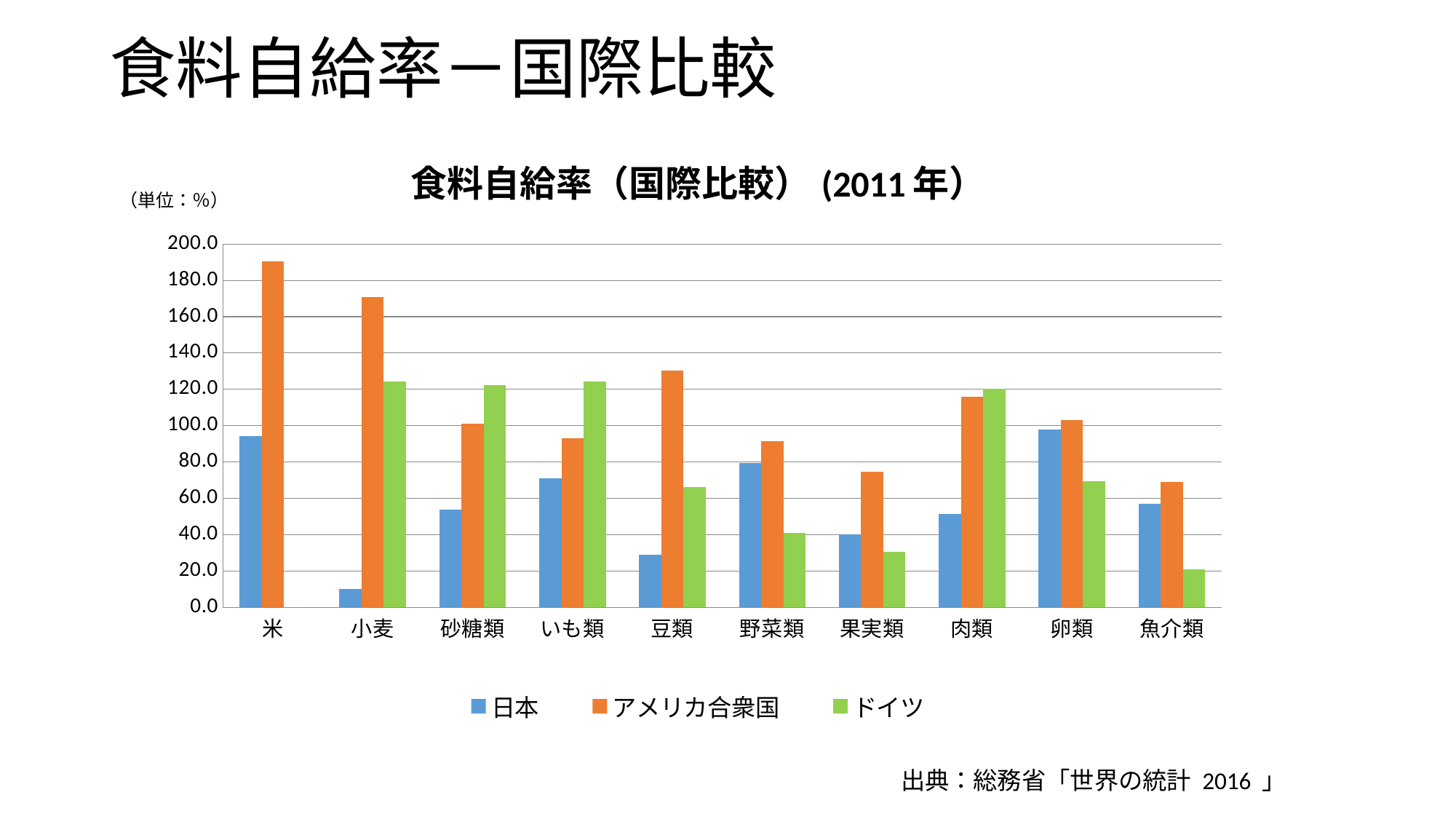
How many series does the legend list? 3 Is the value for ドイツ in 肉類 greater or less than 100? greater In 小麦, which is larger: the value for アメリカ合衆国 or the value for ドイツ? アメリカ合衆国 In 野菜類, which is larger: the value for 日本 or the value for ドイツ? 日本 What is the title of the chart? 食料自給率（国際比較）(2011年) How many categories are shown on the x axis? 10 For which category is the value for 日本 the lowest? 小麦 Is the value for アメリカ合衆国 in 米 greater or less than 180? greater What kind of chart is shown on the slide? bar chart Is the value for 日本 in 小麦 greater or less than 20? less For which category is the value for アメリカ合衆国 the highest? 米